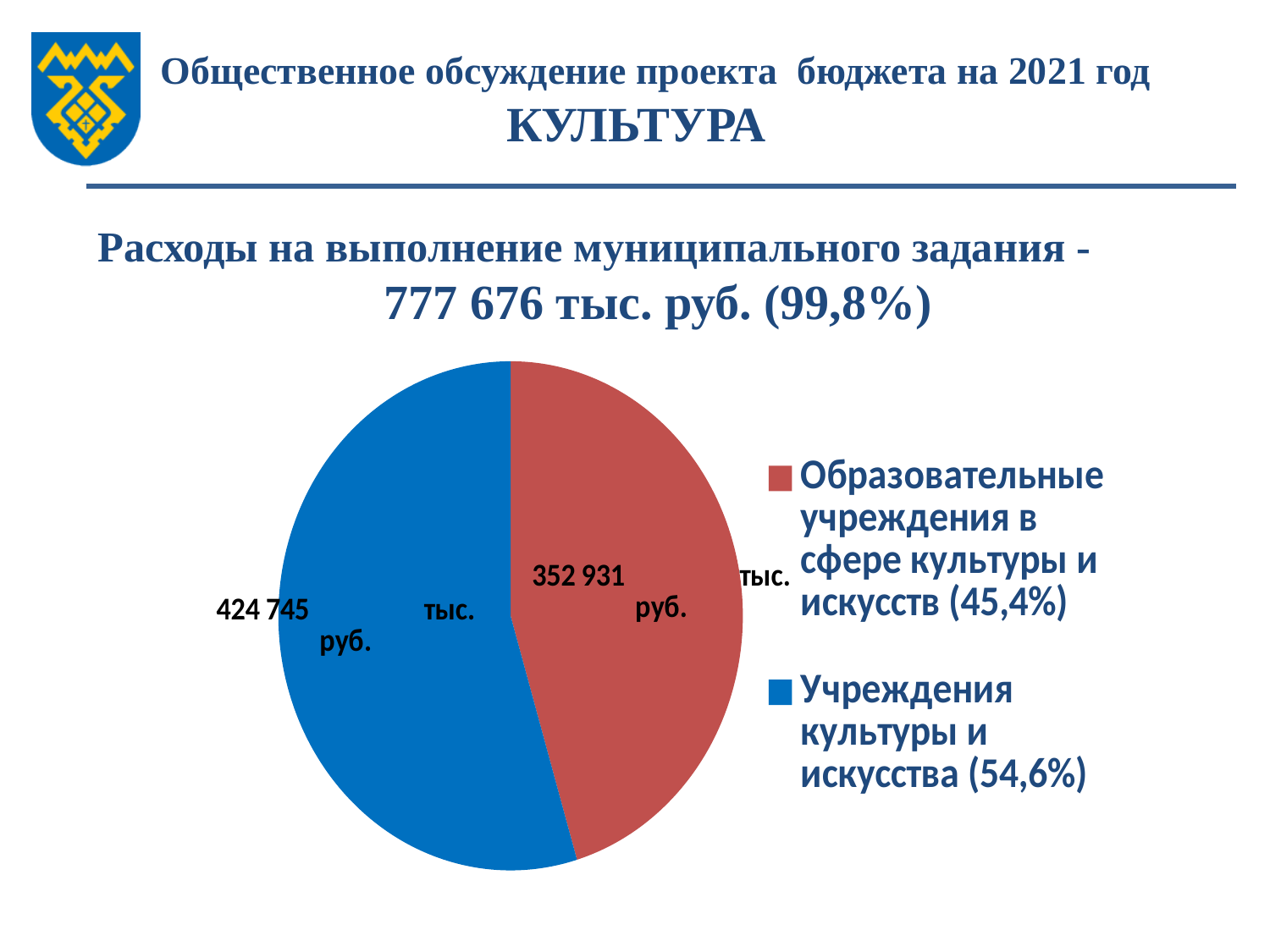
How many slices does the pie chart have? 2 What colour is the slice for "Учреждения культуры и искусства"? blue Which is larger: the value for "Образовательные учреждения в сфере культуры и искусств" or for "Учреждения культуры и искусства"? Учреждения культуры и искусства Which slice of the pie chart is the largest? Учреждения культуры и искусства What share of the pie does "Учреждения культуры и искусства" represent? 54,6% What is the value shown for "Образовательные учреждения в сфере культуры и искусств"? 352 931 тыс. руб. What is the difference between the values for "Учреждения культуры и искусства" and "Образовательные учреждения в сфере культуры и искусств"? 71 814 тыс. руб. How many entries does the legend list? 2 What share of the pie does "Образовательные учреждения в сфере культуры и искусств" represent? 45,4% Which slice of the pie chart is the smallest? Образовательные учреждения в сфере культуры и искусств What is the value shown for "Учреждения культуры и искусства"? 424 745 тыс. руб. What kind of chart is shown on the slide? pie chart